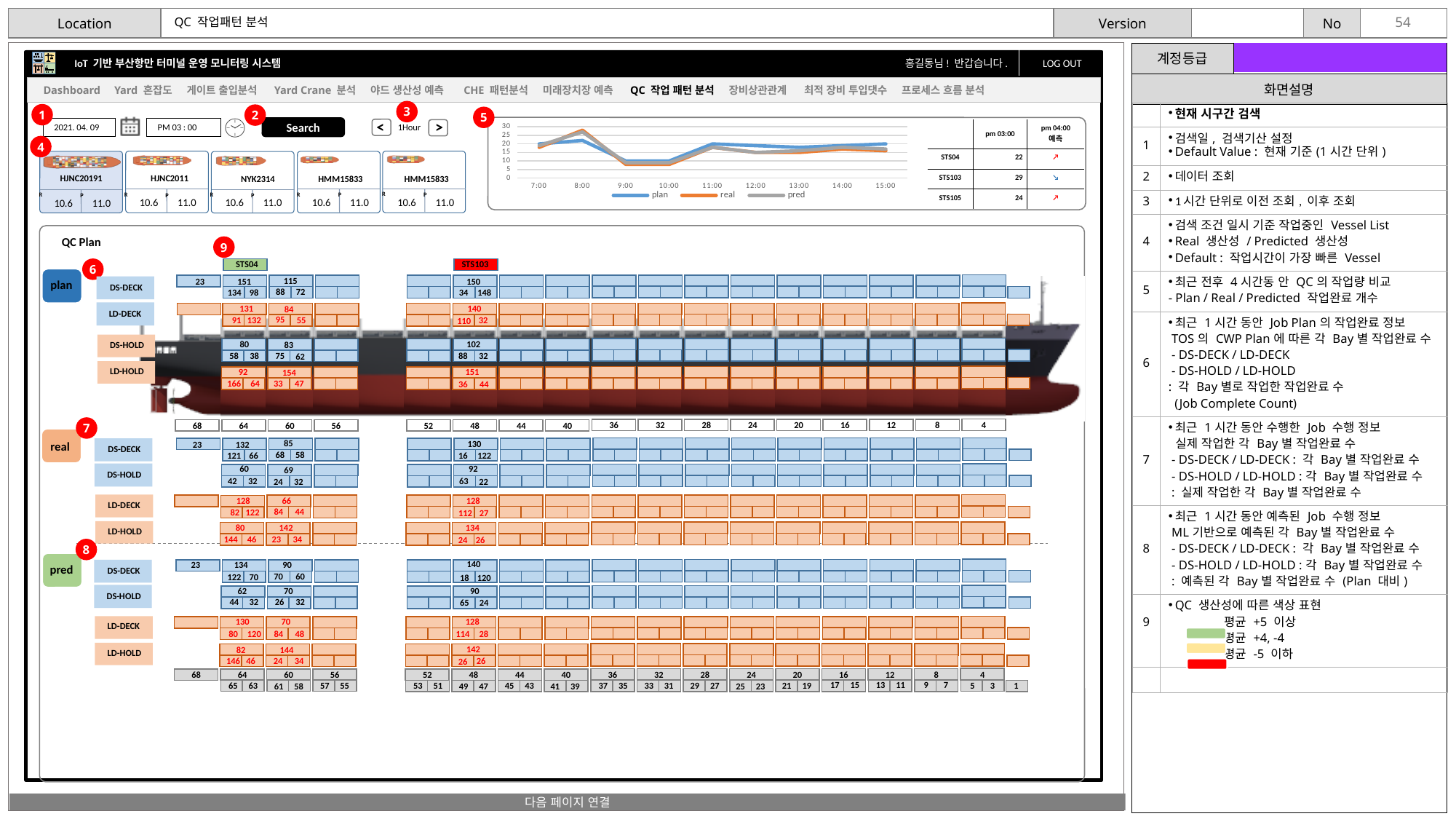
What are the three series named in the legend of the line chart in the top panel? plan, real, pred How many series does the legend of the line chart in the top panel list? 3 What is the highest value shown on the y axis of the line chart in the top panel? 30 In the line chart in the top panel, is the value of the real series at 15:00 greater or less than 10? greater In the line chart in the top panel, is the value of the pred series at 12:00 greater or less than 20? less In the line chart in the top panel, do the series values rise or fall between 7:00 and 8:00? rise In the line chart in the top panel, is the value of the real series at 8:00 greater or less than 20? greater In the line chart in the top panel, at which time does the real series reach its highest value? 8:00 What kind of chart is shown in the top panel (item 5) with the plan, real and pred series? line chart In the line chart in the top panel, do the series values rise or fall between 8:00 and 9:00? fall How many time ticks are shown on the x axis of the line chart in the top panel? 9 In the line chart in the top panel, at 8:00 which series has the larger value, plan or real? real